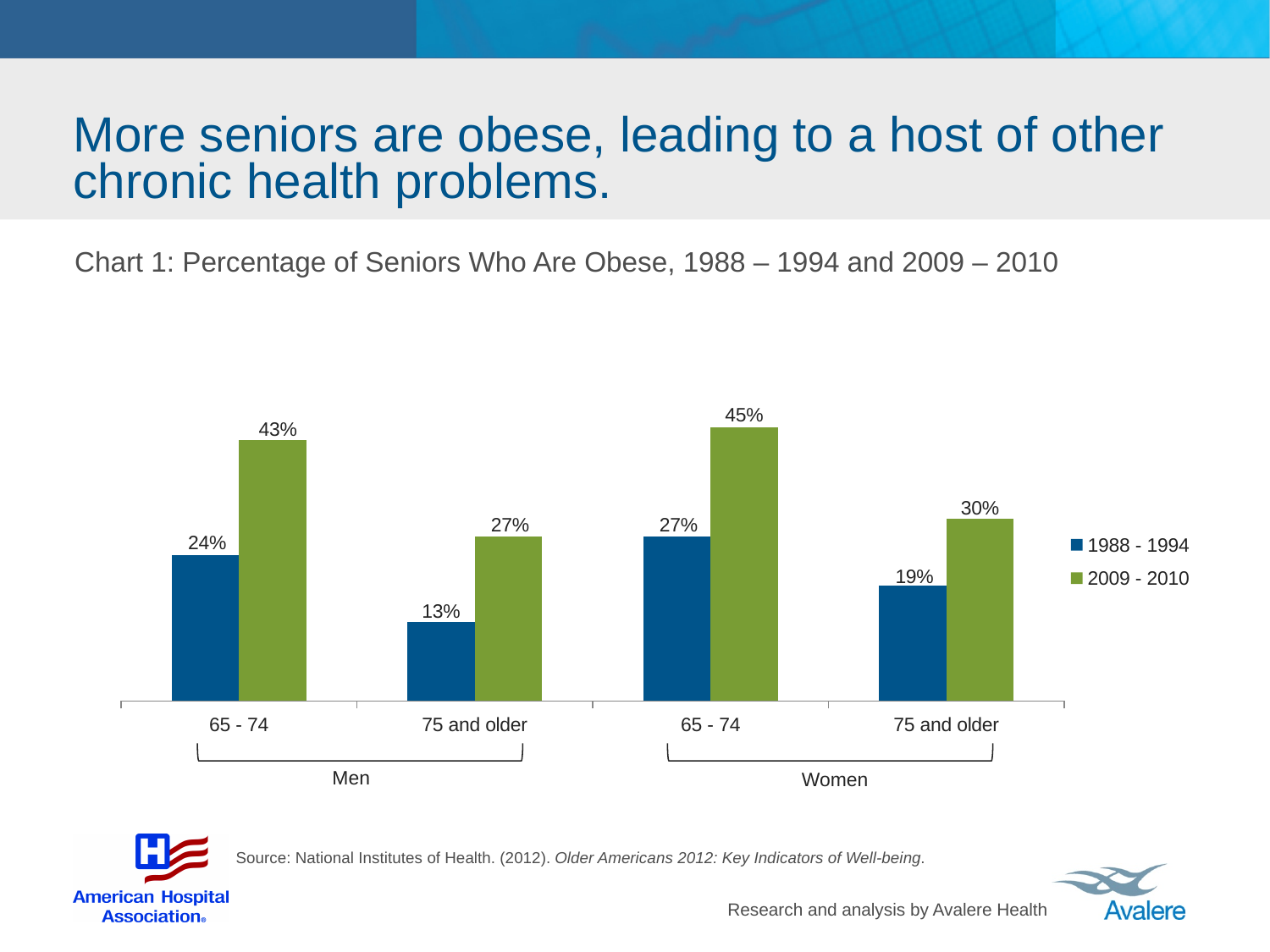
How many age-group categories are shown along the x axis? 4 What percentage of men aged 75 and older were obese in 1988 - 1994? 13% How many series does the legend list? 2 What kind of chart is shown on the slide? Bar chart Which group has the lowest obesity percentage shown on the chart? Men 75 and older, 1988 - 1994 In 2009 - 2010, which had a higher obesity percentage: men aged 75 and older or women aged 75 and older? Women aged 75 and older Which colour represents the 2009 - 2010 series in the legend? Green Which group has the highest obesity percentage shown on the chart? Women 65 - 74, 2009 - 2010 What is the difference between the 2009 - 2010 obesity percentages for women aged 65 - 74 and women aged 75 and older? 15 percentage points By how many percentage points did obesity among men aged 65 - 74 increase from 1988 - 1994 to 2009 - 2010? 19 percentage points What percentage of men aged 65 - 74 were obese in 2009 - 2010? 43% What percentage of women aged 75 and older were obese in 1988 - 1994? 19%